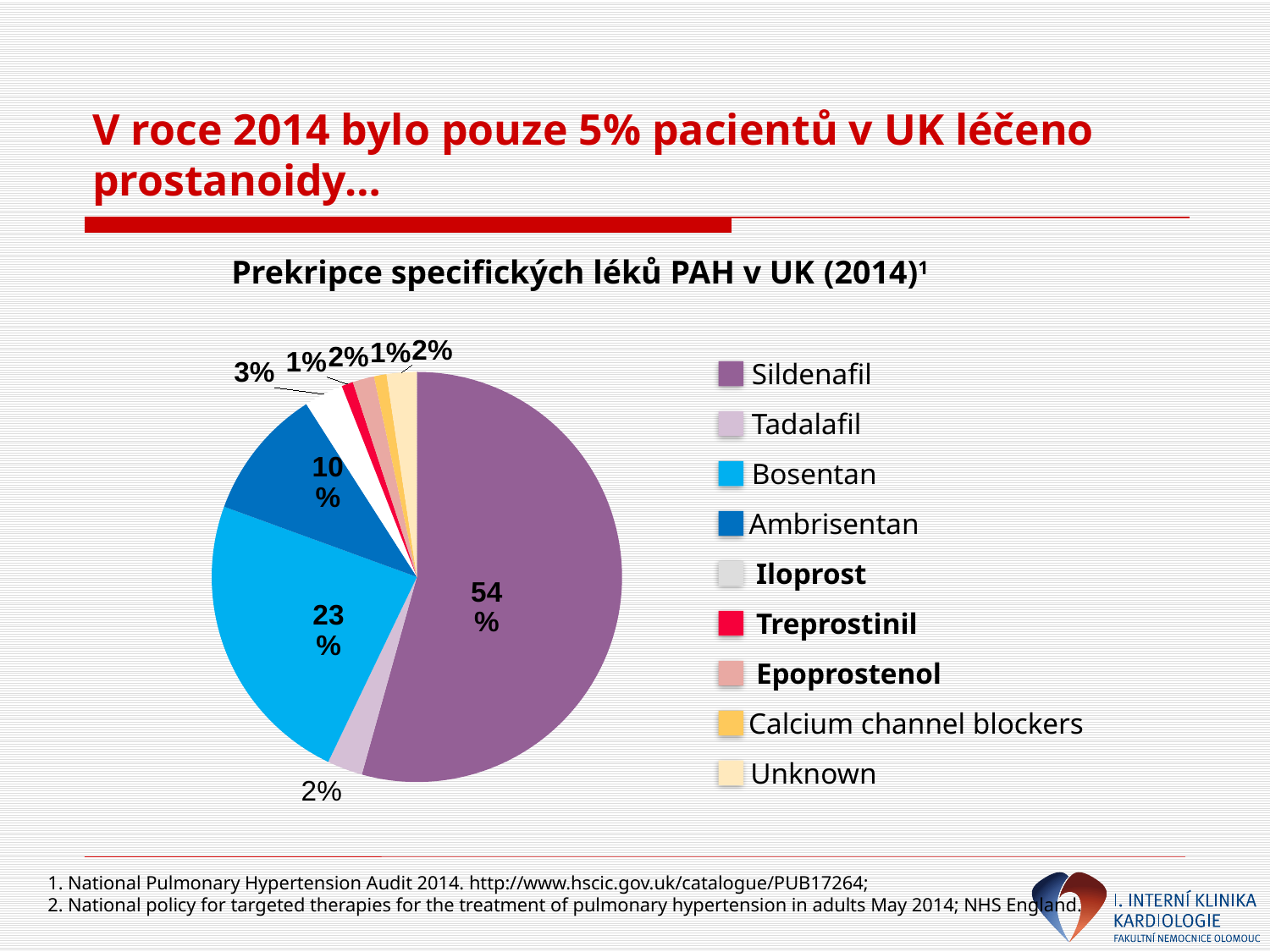
What kind of chart is shown on the slide? Pie chart Which drug has the largest slice of the pie? Sildenafil What share of the pie does Sildenafil have? 54% Which is larger, the share for Bosentan or the share for Ambrisentan? Bosentan How many categories does the legend list? 9 What share of the pie does Tadalafil have? 2% What is the title of the chart? Prekripce specifických léků PAH v UK (2014) What share of the pie does Ambrisentan have? 10% What is the difference in percentage points between the Sildenafil share and the Bosentan share? 31 What colour is the Sildenafil slice? Purple What share of the pie does Bosentan have? 23% What share of the pie does Iloprost have? 3%